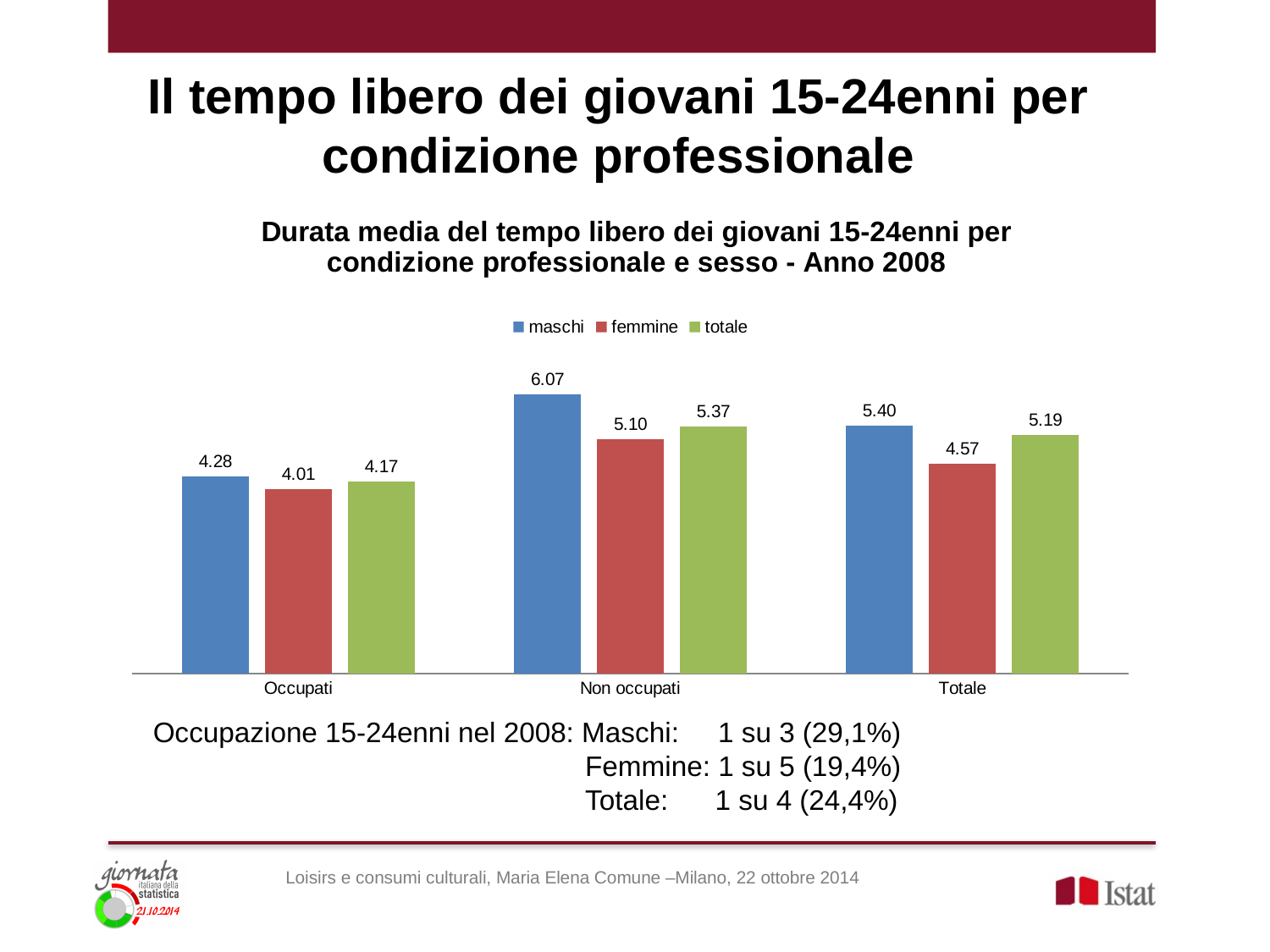
Which category has the highest value for maschi? Non occupati Which category has the lowest value for femmine? Occupati What is the value for totale in the Totale category? 5.19 What is the difference between the maschi and femmine values in the Totale category? 0.83 How many series does the legend list? 3 What is the value for maschi in the Non occupati category? 6.07 What is the value for femmine in the Occupati category? 4.01 Which colour represents the femmine series in the legend? Red What is the difference between the maschi and femmine values in the Non occupati category? 0.97 How many categories are shown on the x axis? 3 What kind of chart is shown on the slide? Bar chart Which is larger: the totale value for Occupati or the totale value for Non occupati? Non occupati